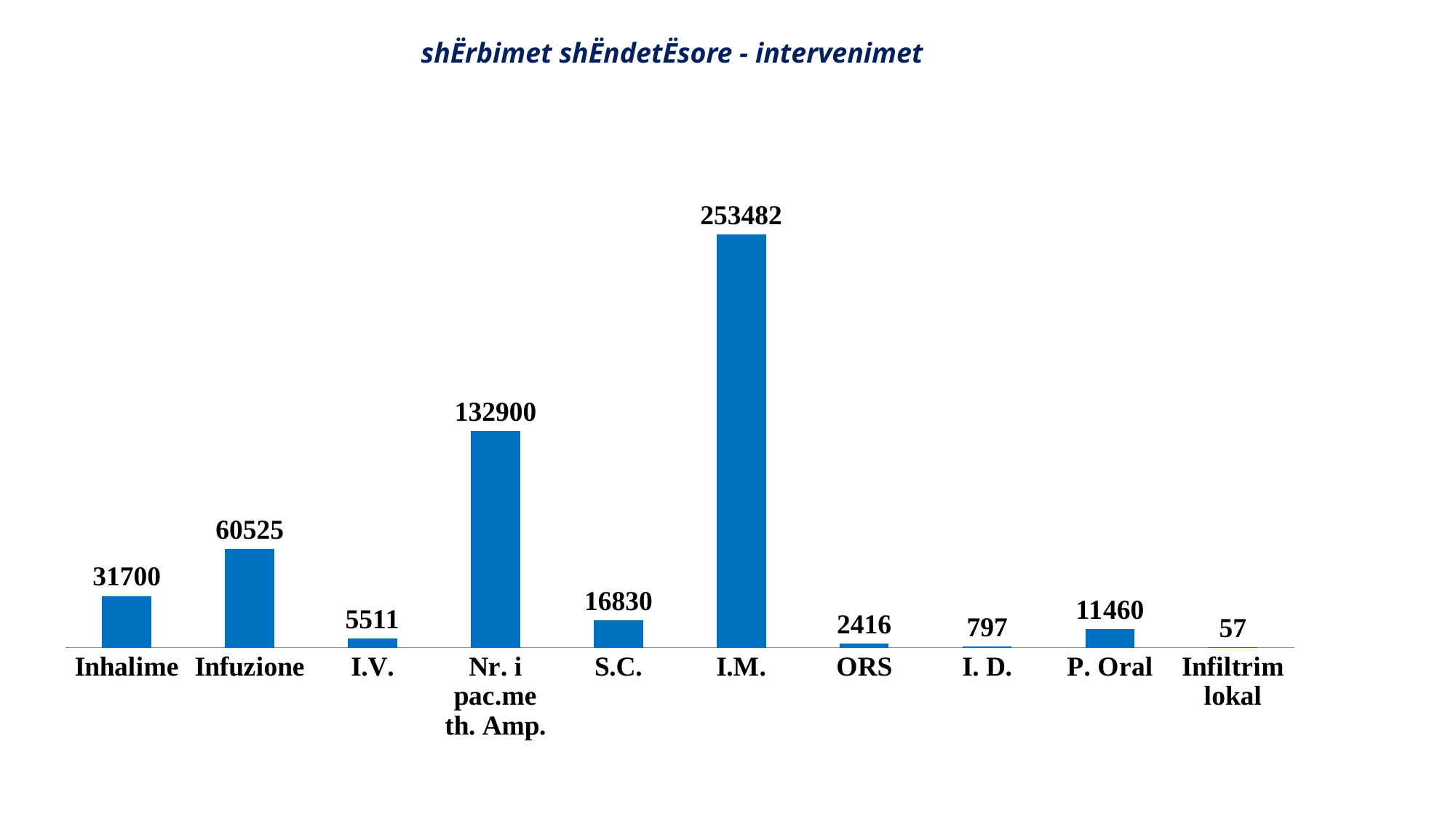
Which is larger, the value for S.C. or the value for P. Oral? S.C. What is the title of the chart? shËrbimet shËndetËsore - intervenimet Which category has the lowest value? Infiltrim lokal What is the value for P. Oral? 11460 What kind of chart is shown on the slide? Bar chart What is the difference between the values for I.M. and Nr. i pac.me th. Amp.? 120582 Which category has the highest value? I.M. What is the difference between the values for Infuzione and Inhalime? 28825 Which is larger, the value for ORS or the value for I. D.? ORS What is the value for Infuzione? 60525 What is the value for I.M.? 253482 How many categories are shown on the x axis? 10